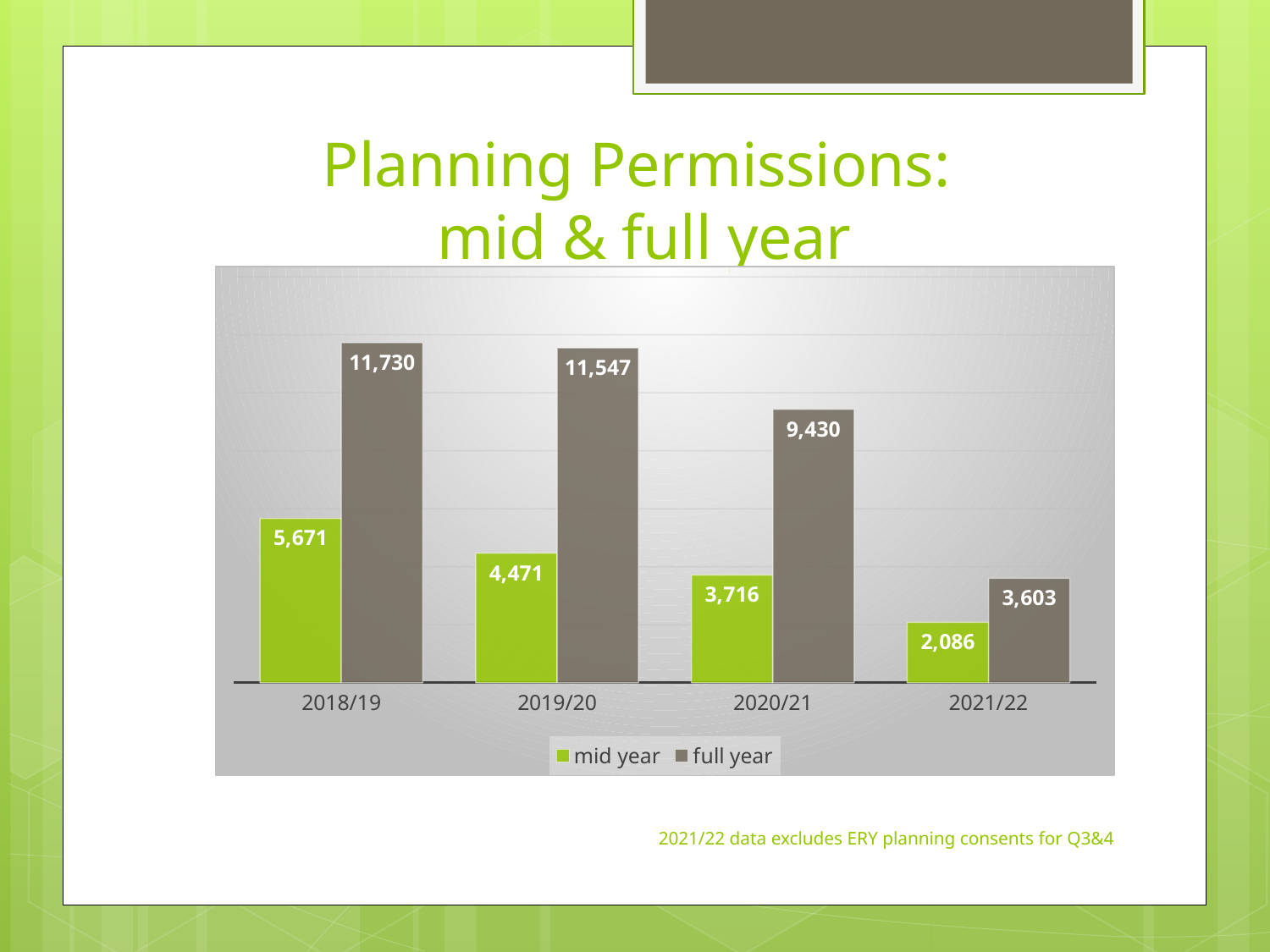
Which year has the highest full year value? 2018/19 What is the full year value for 2021/22? 3,603 What is the title of the chart? Planning Permissions: mid & full year Which is larger: the mid year value for 2018/19 or the full year value for 2021/22? mid year value for 2018/19 What kind of chart is shown? bar chart Which year has the lowest mid year value? 2021/22 How many years are shown on the x axis? 4 What is the full year value for 2020/21? 9,430 What is the difference between the full year and mid year values for 2019/20? 7,076 Do the full year values rise or fall from 2018/19 to 2021/22? fall How many series does the legend list? 2 What is the mid year value for 2018/19? 5,671